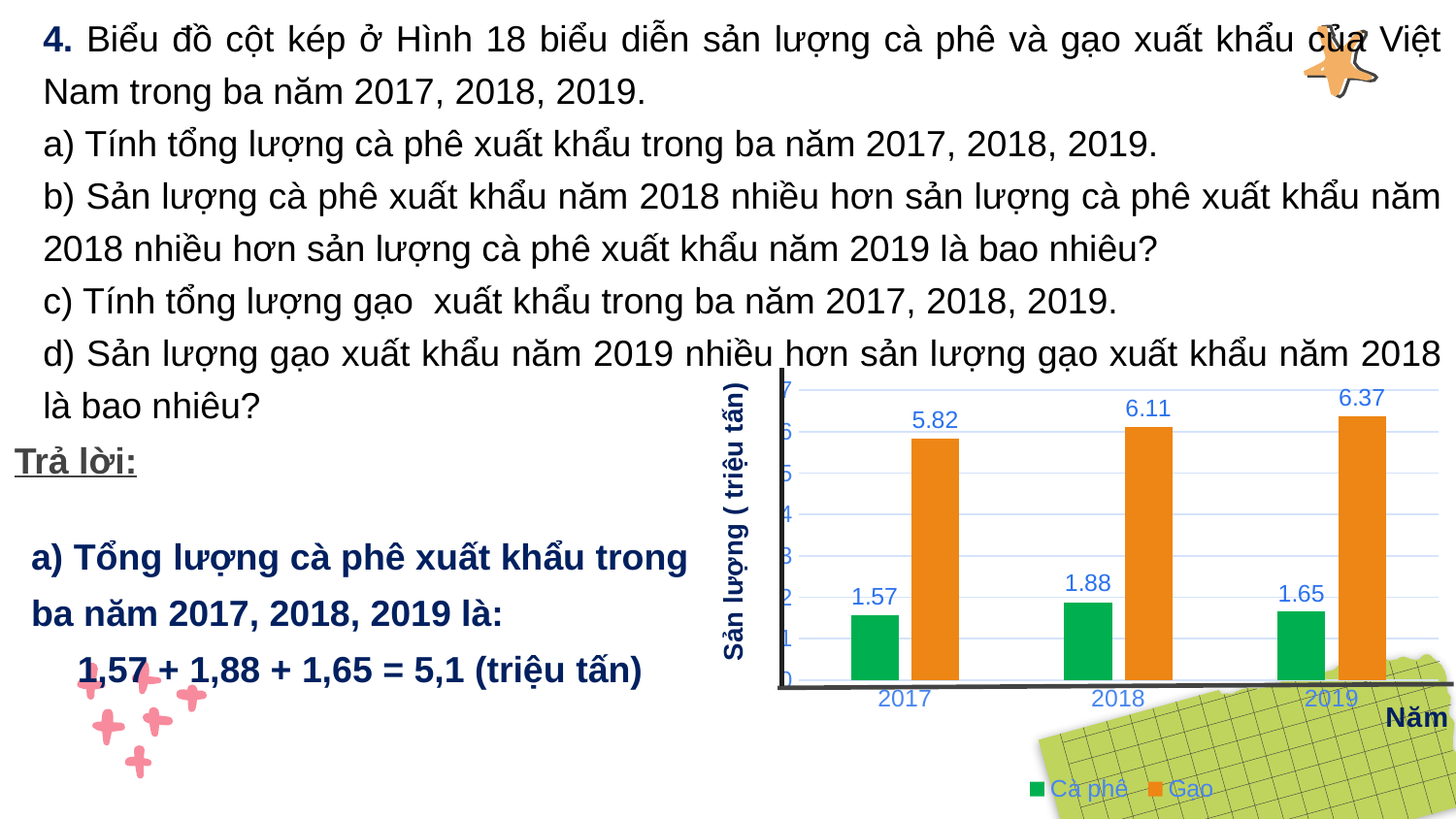
In which year is the Gạo value highest? 2019 What kind of chart is shown on the slide? bar chart What is the value for Cà phê in 2017? 1.57 Which is larger, the Gạo value in 2017 or the Gạo value in 2018? 2018 In which year is the Cà phê value lowest? 2017 How many series does the legend list? 2 Do the Gạo values rise or fall from 2017 to 2019? rise What is the value for Cà phê in 2018? 1.88 What is the value for Gạo in 2019? 6.37 What is the difference between the Gạo values for 2019 and 2018? 0.26 What is the difference between the Cà phê values for 2018 and 2019? 0.23 How many years are shown on the x axis? 3